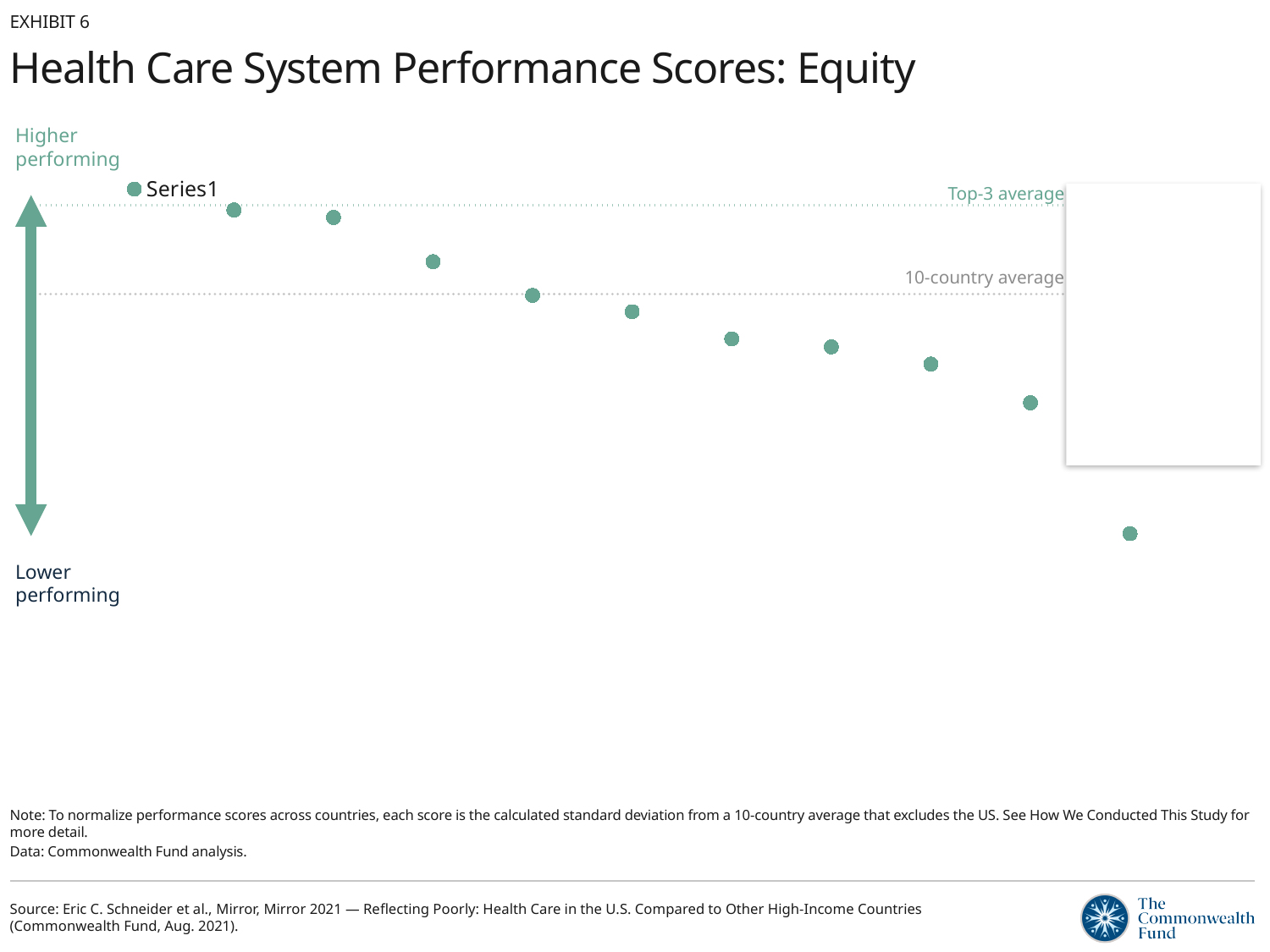
Do the plotted values rise or fall from left to right across the chart? fall Is the leftmost point or the rightmost point higher on the chart? leftmost Which plotted point is the lowest performing: the leftmost or the rightmost? rightmost How many data points are plotted on the chart? 11 What are the two dashed reference lines on the chart labelled? Top-3 average and 10-country average What kind of chart is shown on the slide? scatter chart Which plotted point is the highest performing: the leftmost or the rightmost? leftmost What is the title of the chart? Health Care System Performance Scores: Equity